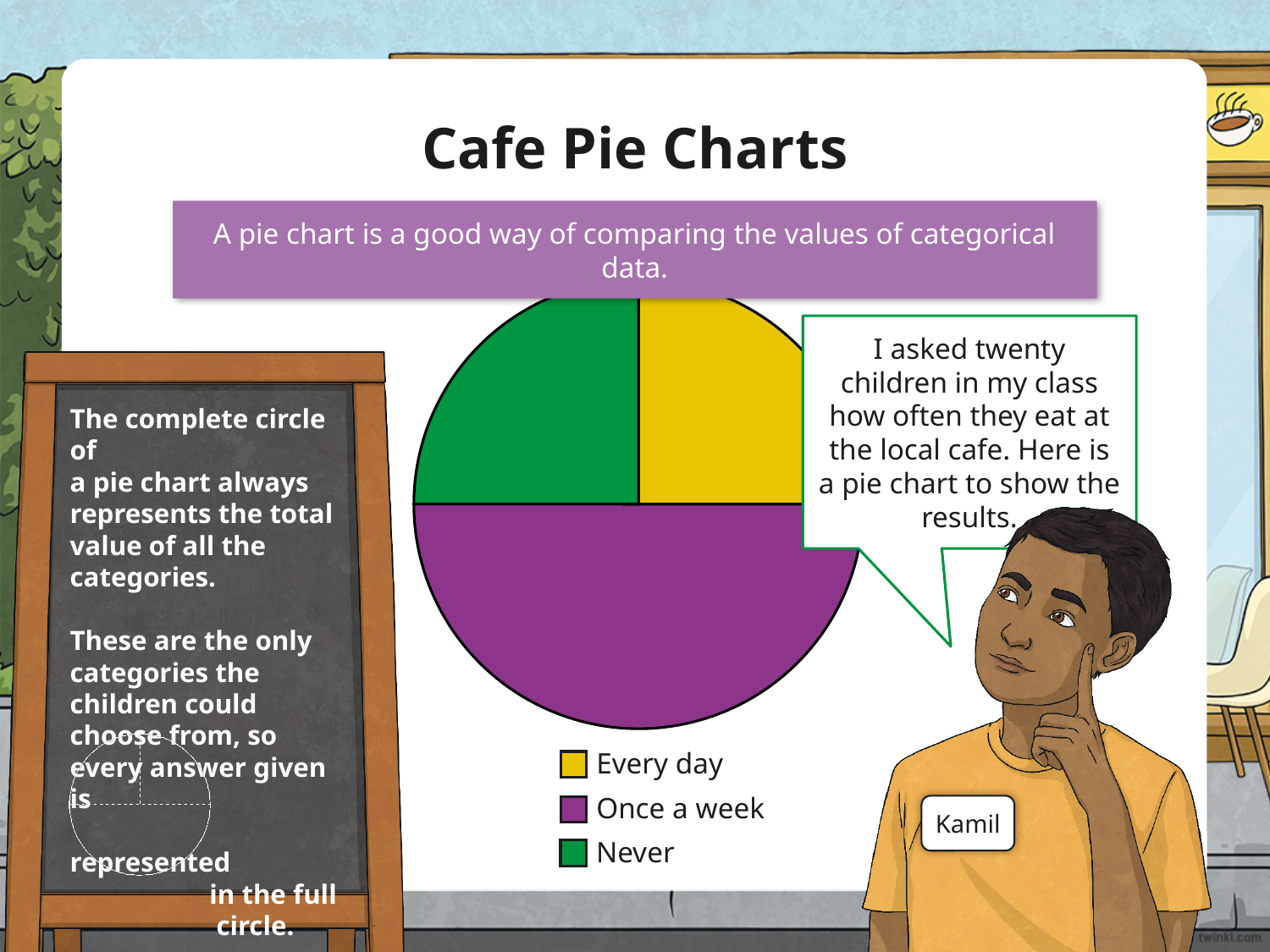
Which category has the largest slice of the pie chart? Once a week Which slice is larger, Once a week or Never? Once a week What kind of chart is shown on the slide? pie chart What colour represents the Never category in the pie chart? green Which category is shown in yellow in the pie chart? Every day Which slice is larger, Once a week or Every day? Once a week How many entries does the legend of the pie chart list? 3 How many categories does the pie chart show? 3